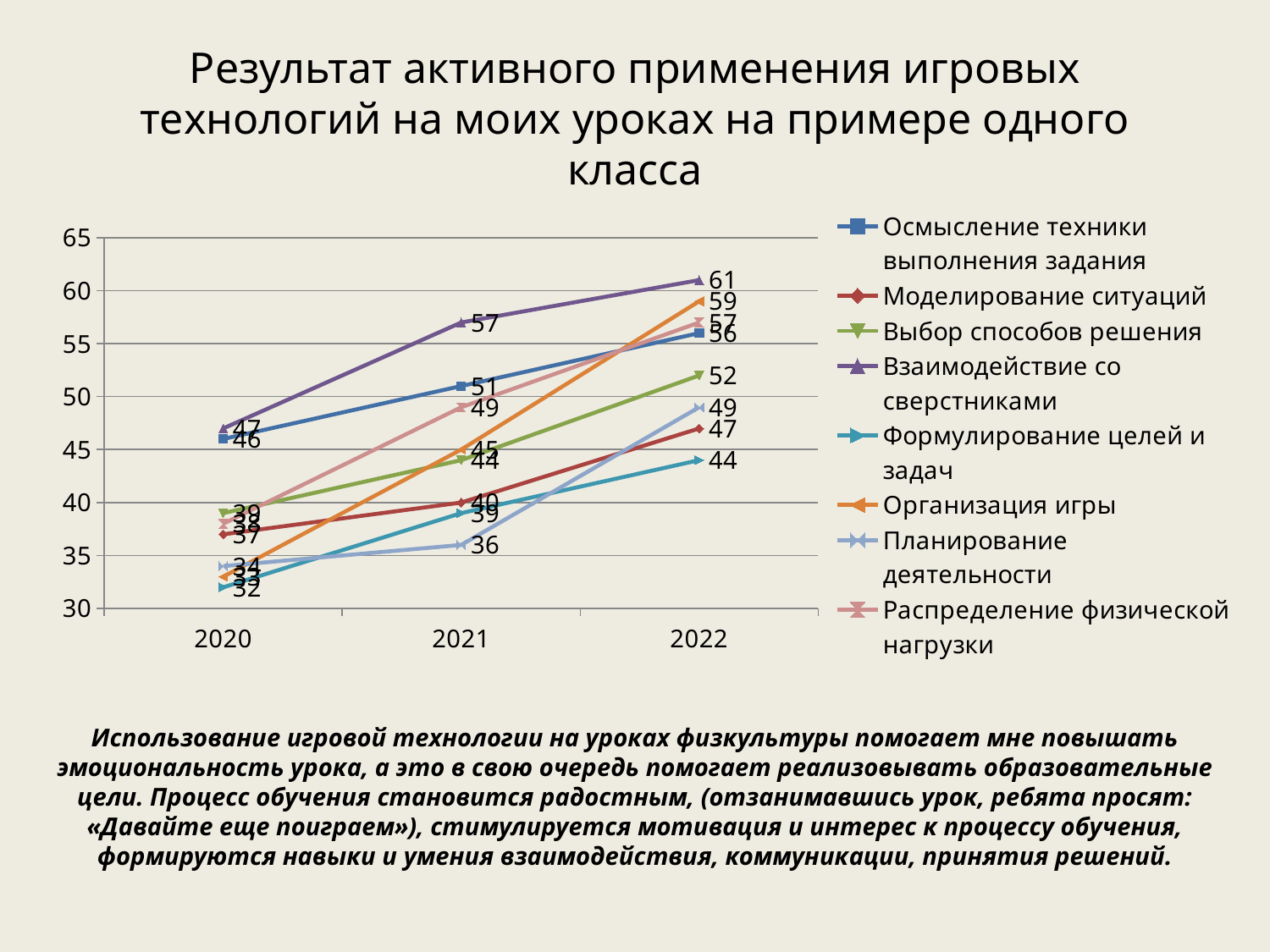
What is the value for Организация игры in 2022? 59 What is the value for Осмысление техники выполнения задания in 2021? 51 What is the value for Взаимодействие со сверстниками in 2022? 61 In 2022, which is larger: Выбор способов решения or Моделирование ситуаций? Выбор способов решения What is the difference between the 2022 values of Взаимодействие со сверстниками and Формулирование целей и задач? 17 What is the value for Планирование деятельности in 2021? 36 Which series has the lowest value in 2022? Формулирование целей и задач What kind of chart is shown on the slide? line chart Which series has the highest value in 2022? Взаимодействие со сверстниками Do the values for Организация игры rise or fall from 2020 to 2022? rise How many years are plotted along the x axis? 3 How many series does the legend list? 8